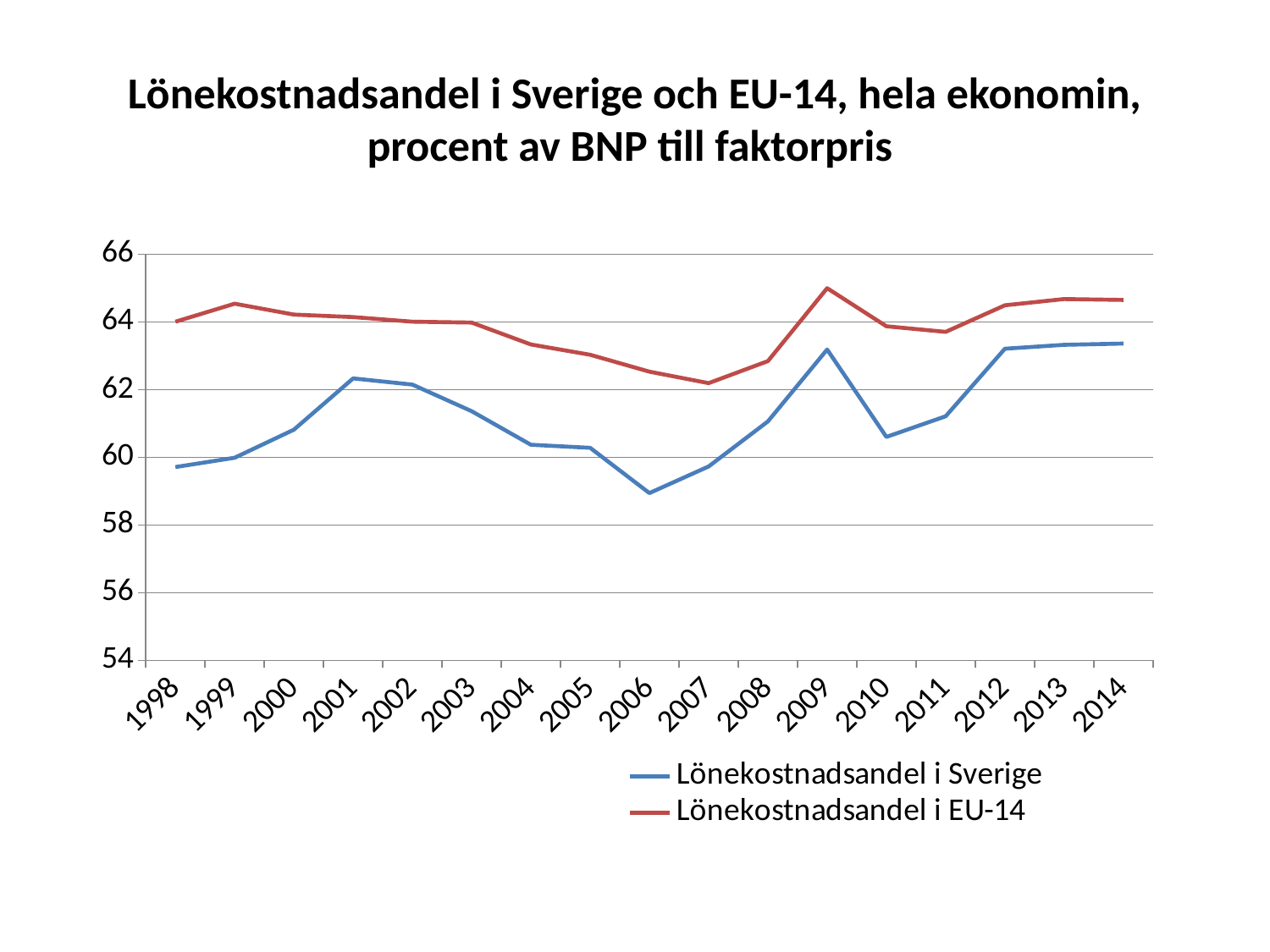
Is the value for Lönekostnadsandel i Sverige in 2001 greater or less than 62? greater How many years are shown on the x axis? 17 Is the value for Lönekostnadsandel i EU-14 in 2007 greater or less than 64? less In which year is the value for Lönekostnadsandel i EU-14 lowest? 2007 Is the value for Lönekostnadsandel i Sverige in 2006 greater or less than 60? less In which year is the value for Lönekostnadsandel i Sverige lowest? 2006 How many series does the legend list? 2 What kind of chart is shown on the slide? line chart In which year is the value for Lönekostnadsandel i EU-14 highest? 2009 Does the value for Lönekostnadsandel i EU-14 rise or fall from 1999 to 2007? fall What colour is the line for Lönekostnadsandel i Sverige? blue Which is larger for Lönekostnadsandel i Sverige: the value in 2009 or the value in 2010? 2009